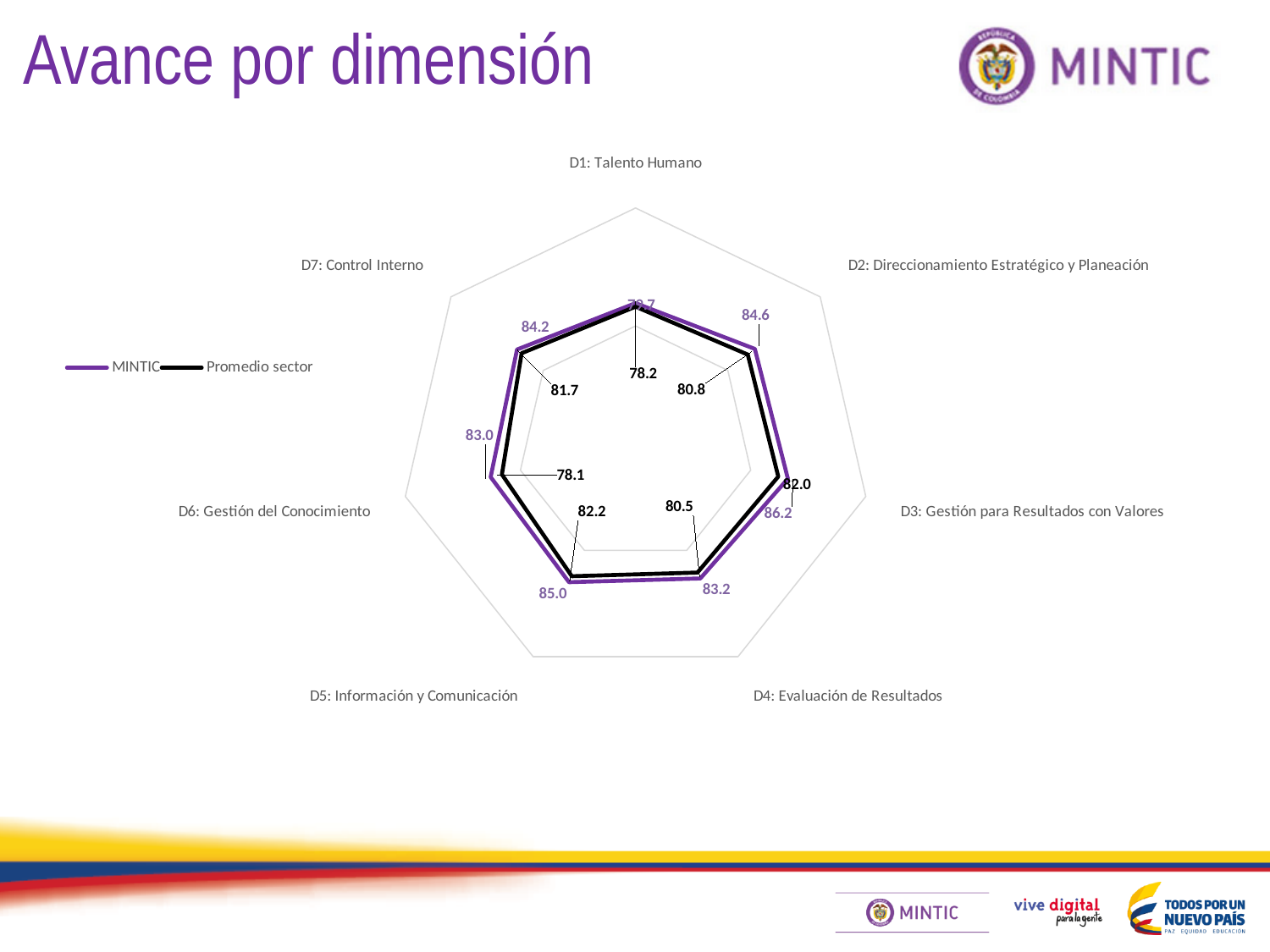
What is the MINTIC value for D3: Gestión para Resultados con Valores? 86.2 Which series is drawn in purple on the chart? MINTIC What is the difference between the MINTIC and Promedio sector values for D6: Gestión del Conocimiento? 4.9 In which dimension does MINTIC have its highest value? D3: Gestión para Resultados con Valores What is the Promedio sector value for D2: Direccionamiento Estratégico y Planeación? 80.8 What is the Promedio sector value for D6: Gestión del Conocimiento? 78.1 How many dimensions (categories) are plotted on the radar chart? 7 For D4: Evaluación de Resultados, which series has the larger value, MINTIC or Promedio sector? MINTIC In which dimension does Promedio sector have its highest value? D5: Información y Comunicación What type of chart is shown on the slide? Radar chart What is the MINTIC value for D5: Información y Comunicación? 85.0 How many series does the legend list? 2